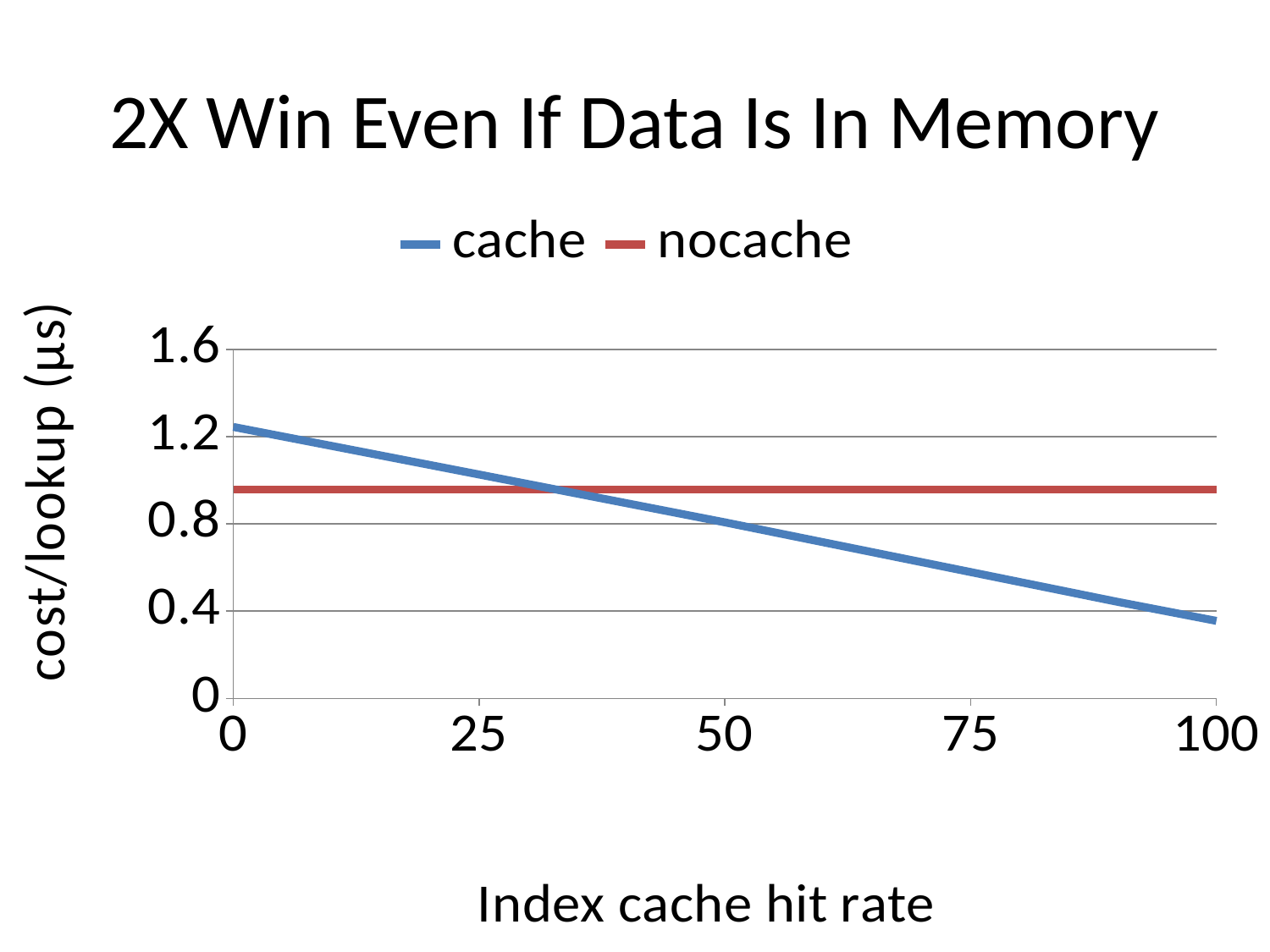
At an index cache hit rate of 0, which series has the higher cost/lookup, cache or nocache? cache Is the cost/lookup for nocache greater or less than 0.8? greater How many series does the legend list? 2 At an index cache hit rate of 100, is the cost/lookup for cache greater or less than 0.4? less What kind of chart is shown on the slide? line chart What is the label of the x axis? Index cache hit rate Is the cost/lookup for nocache greater or less than 1.2? less What is the title of the slide? 2X Win Even If Data Is In Memory At an index cache hit rate of 100, which series has the higher cost/lookup, cache or nocache? nocache Does the cache series rise or fall as the index cache hit rate increases? fall Does the nocache series rise, fall, or stay flat as the index cache hit rate increases? stay flat